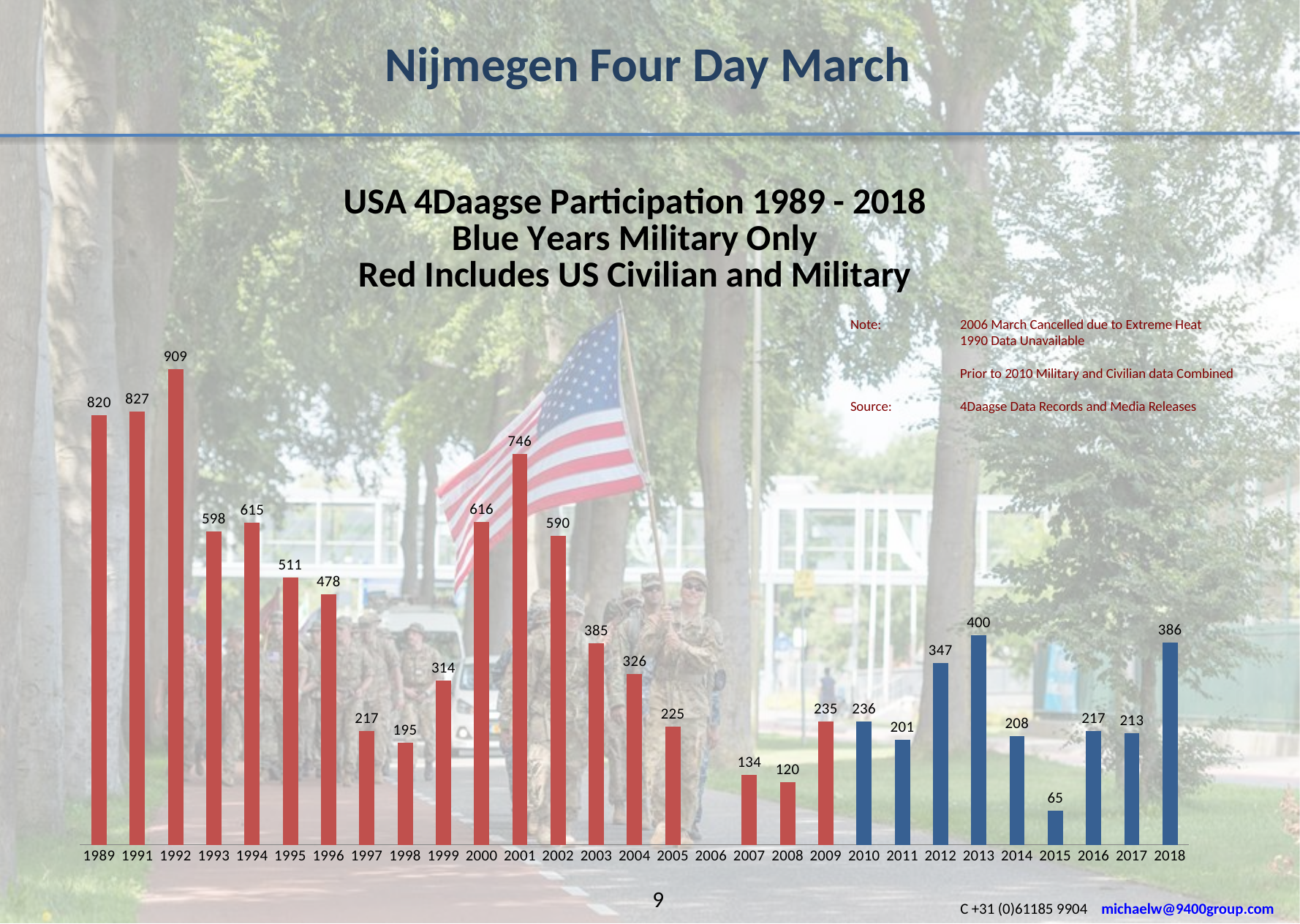
Which year has the highest value? 1992 What is the difference between the values for 2013 and 2012? 53 How many blue bars are there? 9 Which year has the lowest value? 2015 Which is larger, the value for 2000 or the value for 2002? 2000 Which year on the x axis has no bar? 2006 What is the value for 1992? 909 Do the values rise or fall from 1992 to 1998? fall What is the value for 2018? 386 What is the difference between the values for 1991 and 1989? 7 What kind of chart is shown? bar chart What is the value for 2015? 65